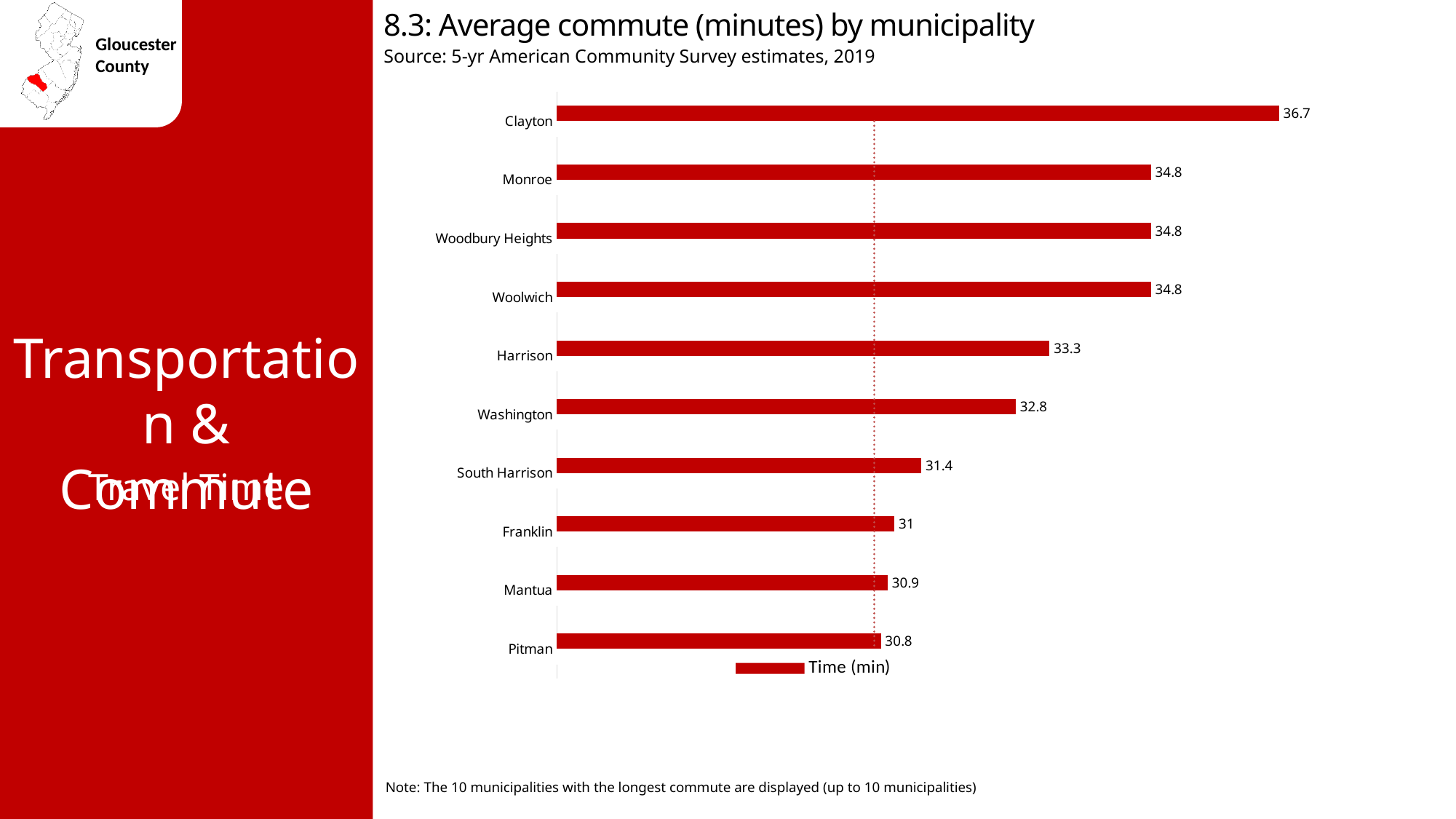
What is the average commute time for Pitman? 30.8 Which municipality has the shortest average commute shown on the chart? Pitman What is the difference in average commute time between Clayton and Pitman? 5.9 How many municipalities are shown on the chart? 10 What kind of chart is shown on the slide? Bar chart Which municipality has the longest average commute? Clayton What is the average commute time for Clayton? 36.7 What is the difference in average commute time between Monroe and Washington? 2 Which has a longer average commute, Harrison or South Harrison? Harrison How many series does the legend list? 1 What is the average commute time for Harrison? 33.3 What is the legend entry for the series on the chart? Time (min)